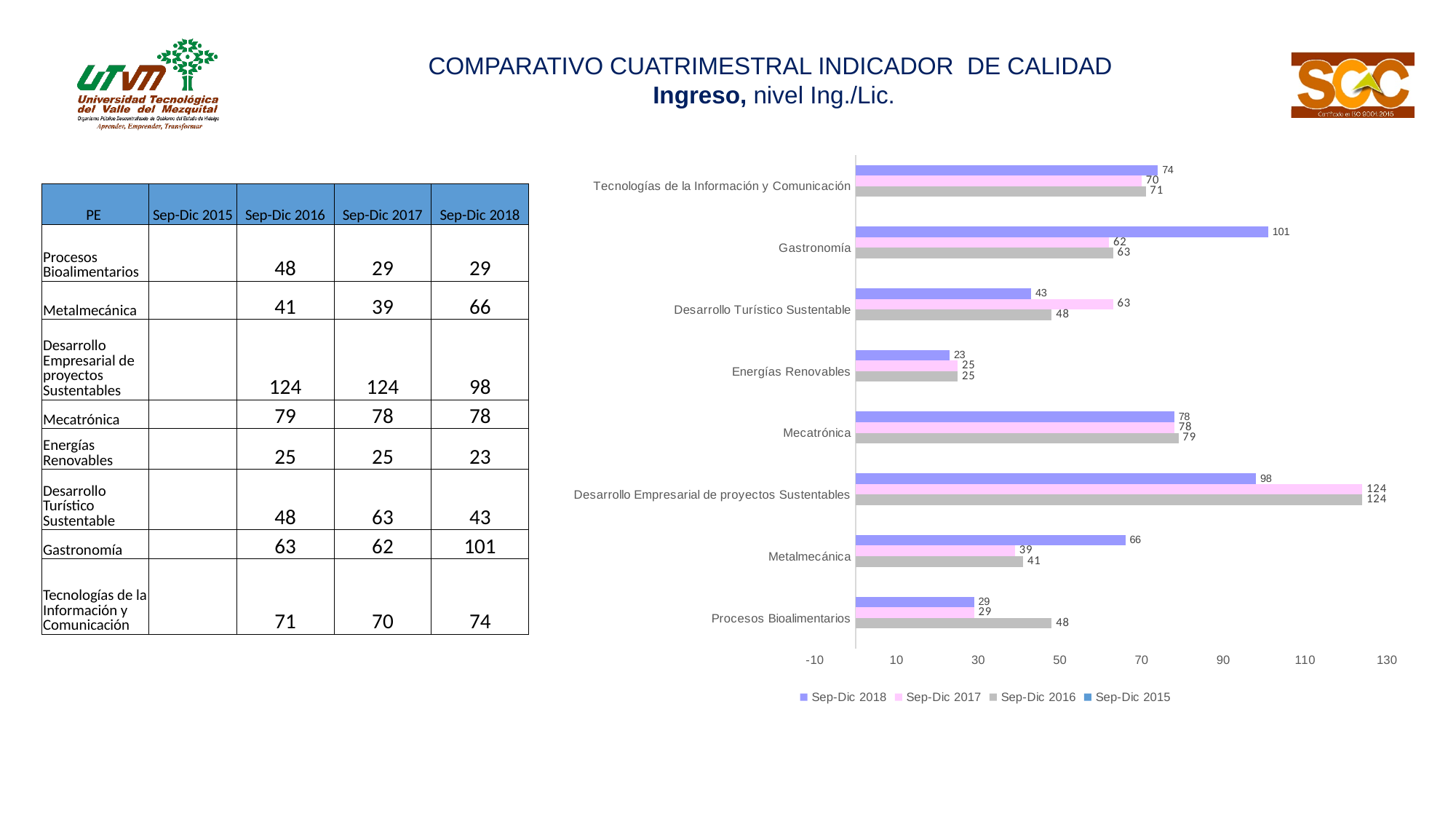
Which legend series has no bars plotted on the chart? Sep-Dic 2015 For Desarrollo Empresarial de proyectos Sustentables, which is larger: the Sep-Dic 2017 value or the Sep-Dic 2018 value? Sep-Dic 2017 How many series does the chart legend list? 4 What is the Sep-Dic 2017 value for Desarrollo Turístico Sustentable? 63 What is the difference between the Sep-Dic 2018 and Sep-Dic 2017 values for Metalmecánica? 27 Is the Sep-Dic 2016 value for Mecatrónica greater or less than 70? greater Which category has the lowest Sep-Dic 2018 value? Energías Renovables What is the Sep-Dic 2016 value for Procesos Bioalimentarios? 48 Which category has the highest Sep-Dic 2018 value? Gastronomía What kind of chart is shown on the slide? Bar chart What is the Sep-Dic 2018 value for Gastronomía? 101 How many categories (programs) are plotted on the chart? 8